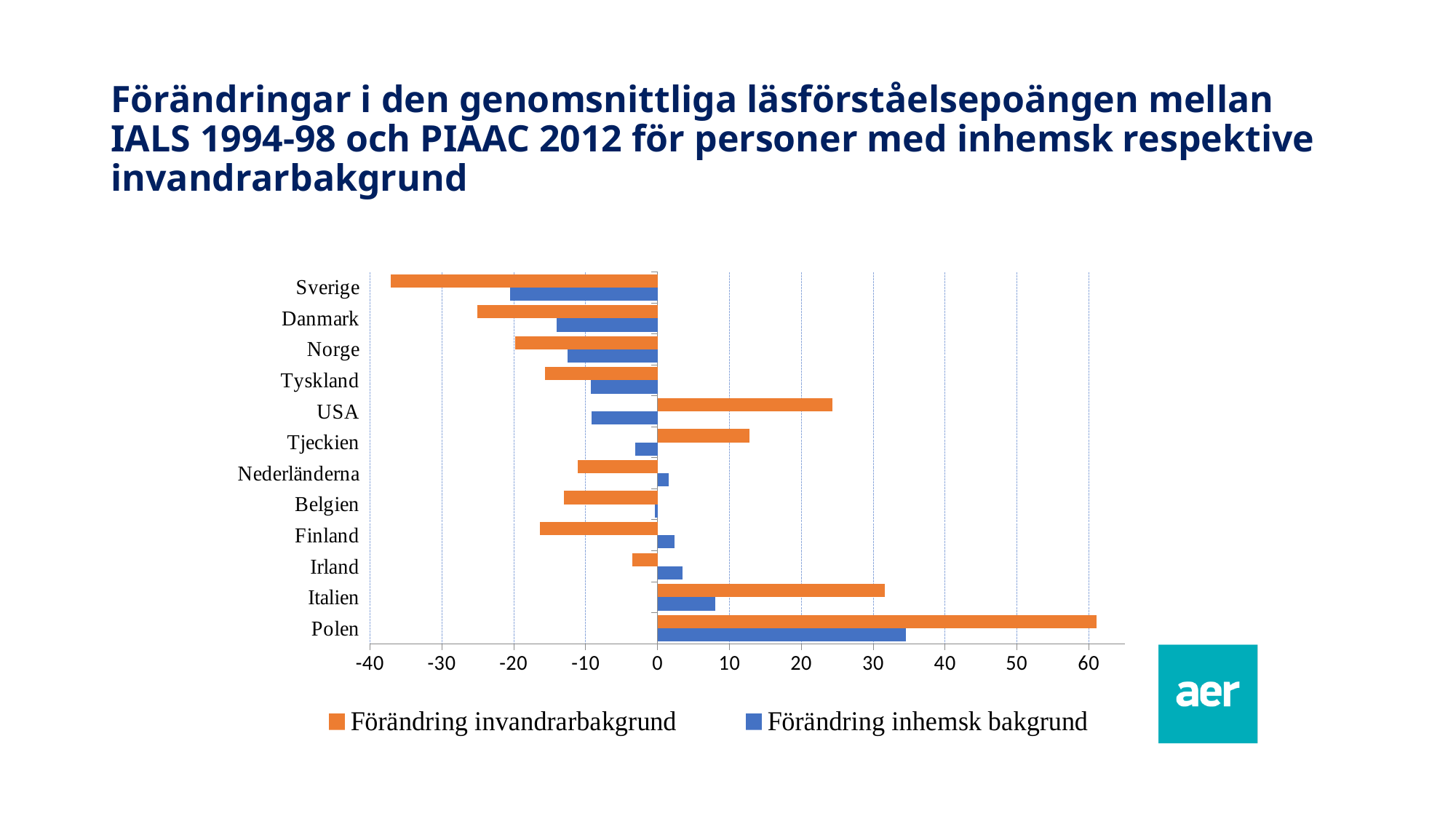
Which country has the highest value for Förändring invandrarbakgrund? Polen What kind of chart is shown on the slide? bar chart Is the Förändring invandrarbakgrund value for Polen greater or less than 50? greater Which country has the lowest value for Förändring inhemsk bakgrund? Sverige How many countries are listed on the chart? 12 How many series does the legend list? 2 Which colour represents the Förändring invandrarbakgrund series? orange Which country has the lowest value for Förändring invandrarbakgrund? Sverige Is the Förändring invandrarbakgrund value for Sverige greater or less than -30? less Which has the larger Förändring invandrarbakgrund value, USA or Tjeckien? USA Which country has the highest value for Förändring inhemsk bakgrund? Polen Is the Förändring inhemsk bakgrund value for Polen greater or less than 30? greater